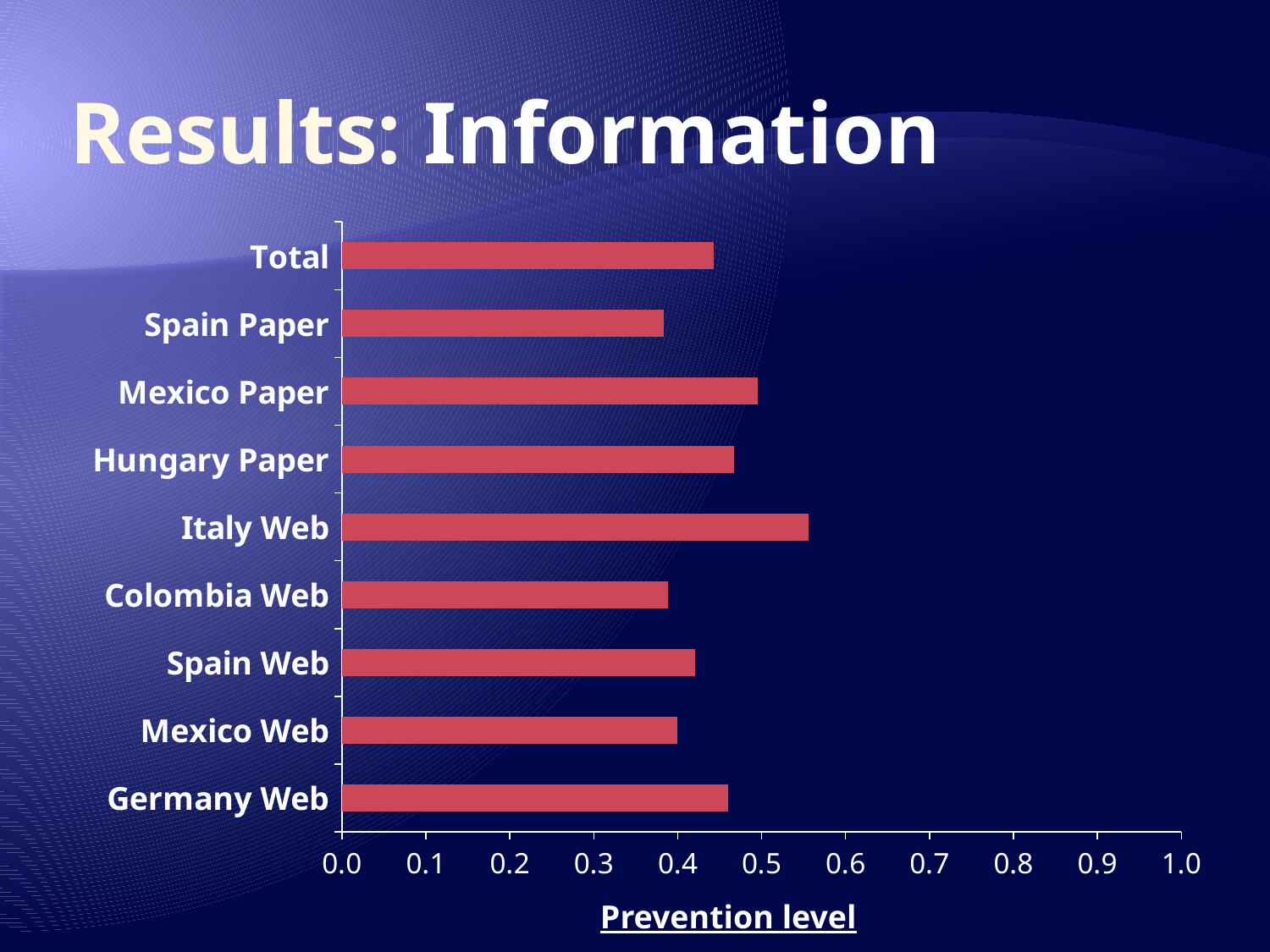
What kind of chart is shown on the slide? bar chart How many categories are plotted in the chart? 9 Is the value for Spain Paper greater or less than 0.4? less Is the value for Hungary Paper greater or less than 0.4? greater Is the value for Italy Web greater or less than 0.5? greater Which category has the highest prevention level? Italy Web Which is larger, the value for Germany Web or the value for Mexico Web? Germany Web What is the title of the horizontal axis of the chart? Prevention level Which is larger, the value for Mexico Paper or the value for Spain Web? Mexico Paper Which is larger, the value for Italy Web or the value for Spain Paper? Italy Web